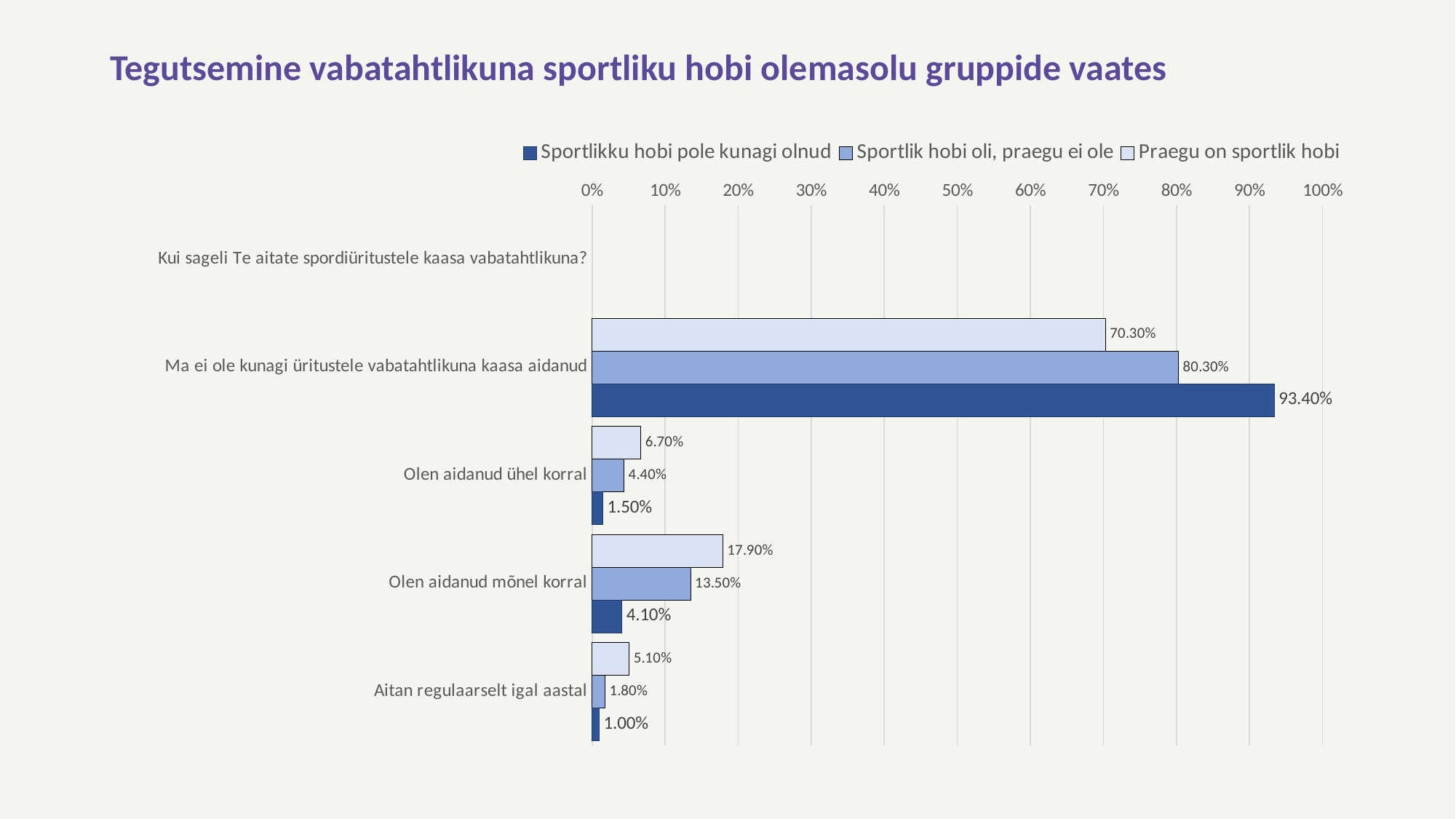
What is the value for 'Sportlikku hobi pole kunagi olnud' in the category 'Olen aidanud ühel korral'? 1.50% Which series has the lowest value in the category 'Olen aidanud mõnel korral'? Sportlikku hobi pole kunagi olnud Which series has the highest value in the category 'Ma ei ole kunagi üritustele vabatahtlikuna kaasa aidanud'? Sportlikku hobi pole kunagi olnud What is the difference between the 'Sportlikku hobi pole kunagi olnud' and 'Praegu on sportlik hobi' values in the category 'Ma ei ole kunagi üritustele vabatahtlikuna kaasa aidanud'? 23.10% What is the difference between the 'Praegu on sportlik hobi' and 'Sportlik hobi oli, praegu ei ole' values in the category 'Olen aidanud mõnel korral'? 4.40% Is the value for 'Sportlik hobi oli, praegu ei ole' in the category 'Ma ei ole kunagi üritustele vabatahtlikuna kaasa aidanud' greater or less than 70%? greater How many series does the legend list? 3 Which is larger: the 'Praegu on sportlik hobi' value for 'Olen aidanud ühel korral' or for 'Aitan regulaarselt igal aastal'? Olen aidanud ühel korral What kind of chart is shown on the slide? Bar chart What is the value for 'Praegu on sportlik hobi' in the category 'Olen aidanud mõnel korral'? 17.90% What is the value for 'Sportlik hobi oli, praegu ei ole' in the category 'Aitan regulaarselt igal aastal'? 1.80% What is the value for 'Sportlikku hobi pole kunagi olnud' in the category 'Ma ei ole kunagi üritustele vabatahtlikuna kaasa aidanud'? 93.40%